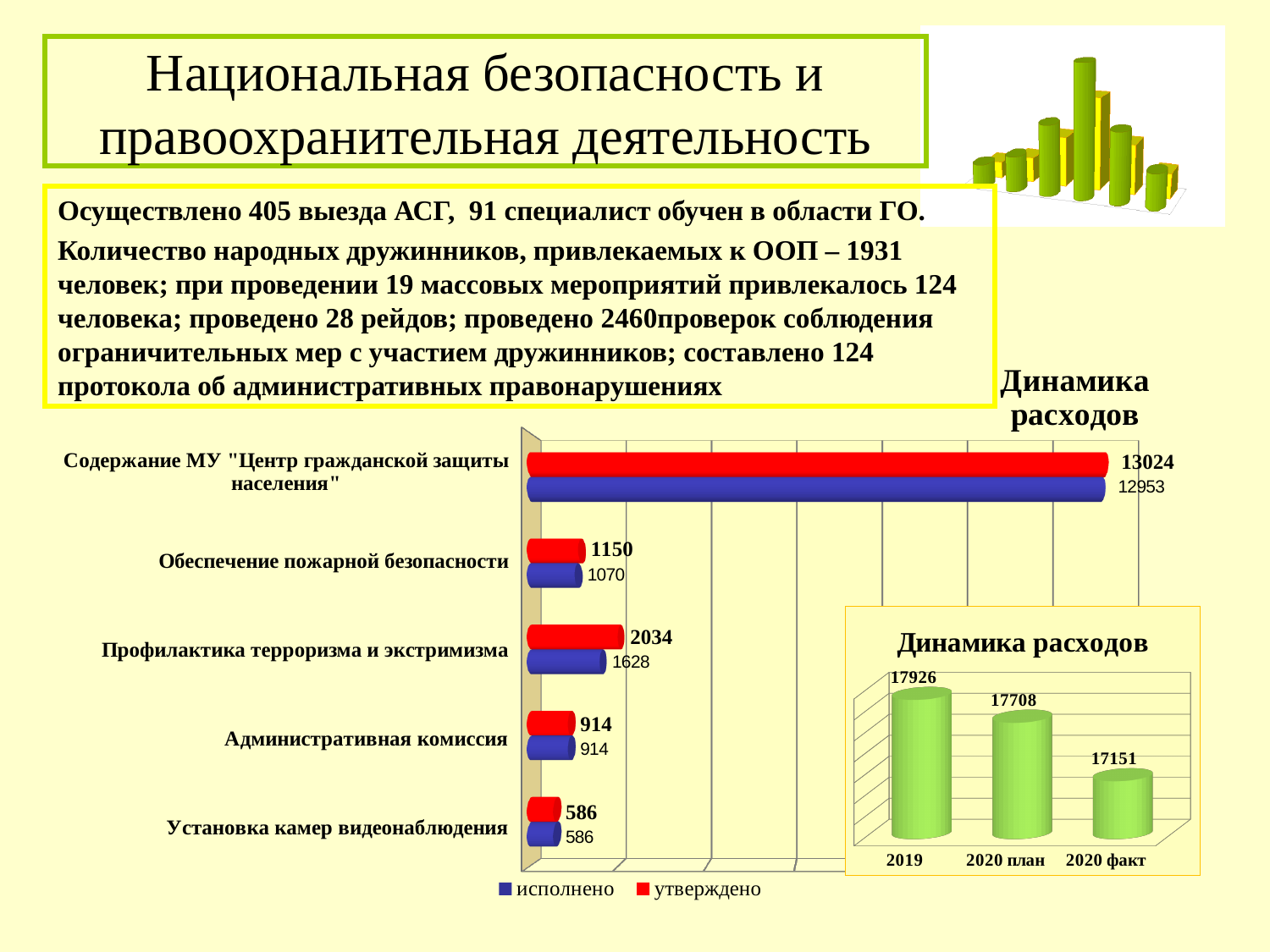
In the Динамика расходов chart, which year or category has the highest value? 2019 In the horizontal bar chart on the left, how many series does the legend list? 2 In the horizontal bar chart on the left, what is the исполнено value for Содержание МУ "Центр гражданской защиты населения"? 12953 In the Динамика расходов chart, what is the difference between the 2020 план and 2020 факт values? 557 In the horizontal bar chart on the left, how many categories are shown? 5 In the horizontal bar chart on the left, which category has the lowest исполнено value? Установка камер видеонаблюдения In the horizontal bar chart on the left, which colour represents исполнено? Blue In the horizontal bar chart on the left, what is the исполнено value for Обеспечение пожарной безопасности? 1070 In the horizontal bar chart on the left, what is the утверждено value for Профилактика терроризма и экстримизма? 2034 In the horizontal bar chart on the left, which category has the highest утверждено value? Содержание МУ "Центр гражданской защиты населения" In the horizontal bar chart on the left, what is the difference between the утверждено and исполнено values for Профилактика терроризма и экстримизма? 406 In the Динамика расходов chart, what is the value for 2020 факт? 17151